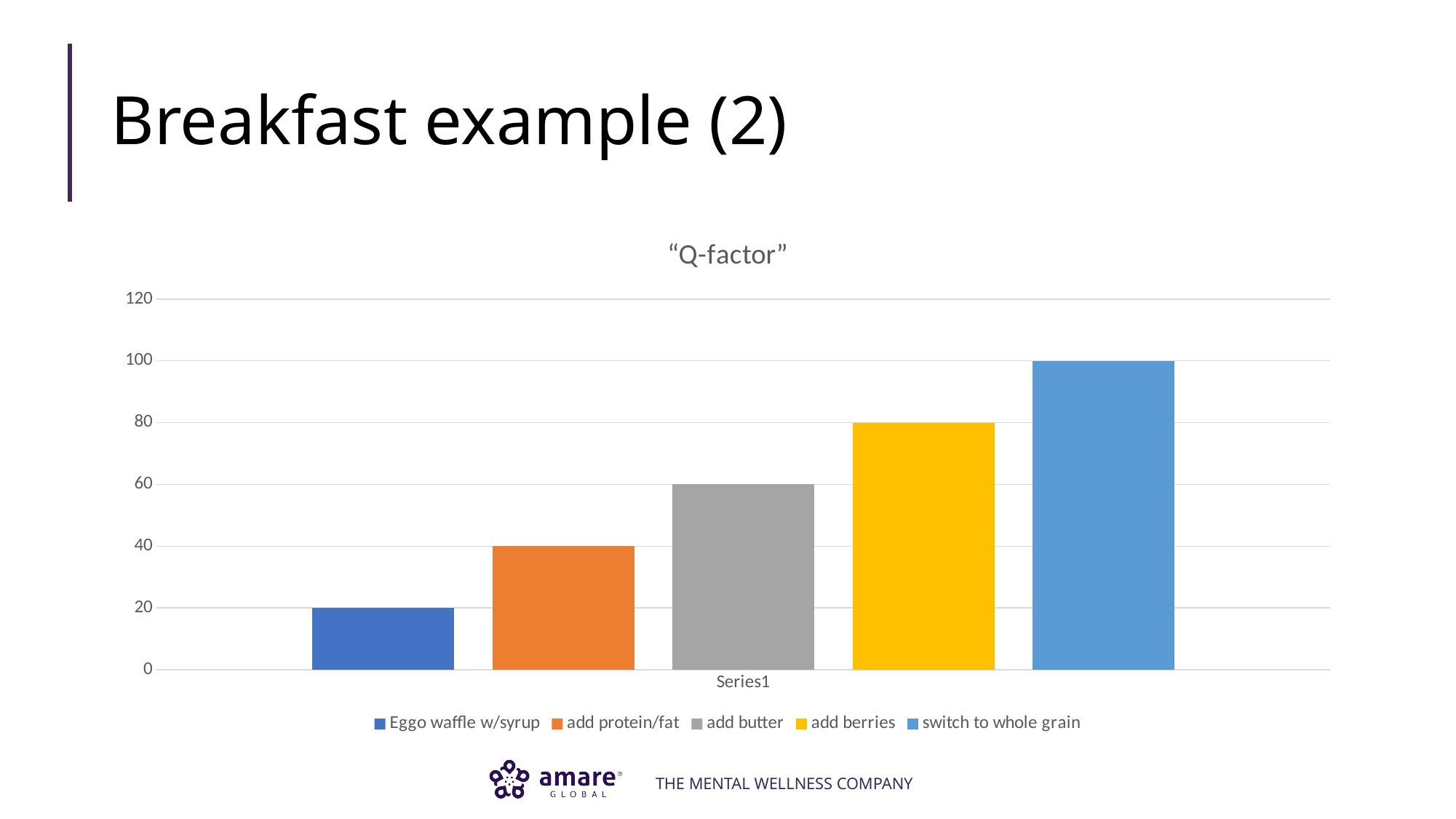
What is the value for add butter? 60 Which legend entry has the lowest value? Eggo waffle w/syrup Which legend entry has the highest value? switch to whole grain What kind of chart is shown on the slide? bar chart What is the value for add berries? 80 Do the bar values rise or fall from left to right across the chart? rise What is the value for Eggo waffle w/syrup? 20 What is the title of the chart? "Q-factor" How many entries does the chart legend list? 5 What is the difference between the values for switch to whole grain and add butter? 40 What is the value for add protein/fat? 40 What is the value for switch to whole grain? 100